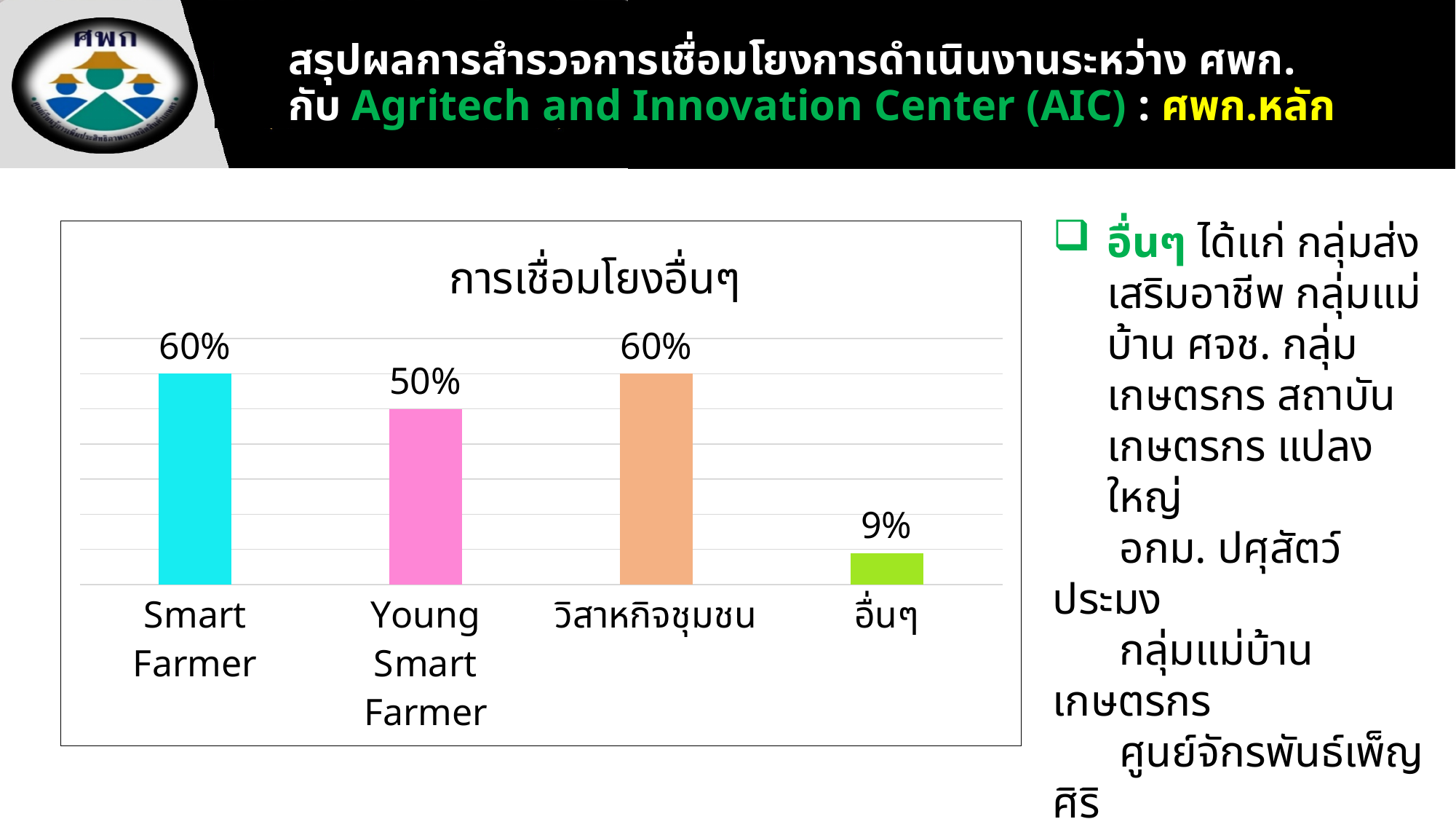
What is the difference between the value for Smart Farmer and the value for Young Smart Farmer? 10% What is the value for อื่นๆ? 9% Which category has the lowest value? อื่นๆ What is the title of the chart? การเชื่อมโยงอื่นๆ How many categories are shown in the chart? 4 What is the value for วิสาหกิจชุมชน? 60% What kind of chart is shown on the slide? Bar chart Which is larger, the value for วิสาหกิจชุมชน or the value for อื่นๆ? วิสาหกิจชุมชน Which is larger, the value for Smart Farmer or the value for Young Smart Farmer? Smart Farmer What is the value for Young Smart Farmer? 50% What is the difference between the value for วิสาหกิจชุมชน and the value for อื่นๆ? 51% What is the value for Smart Farmer? 60%